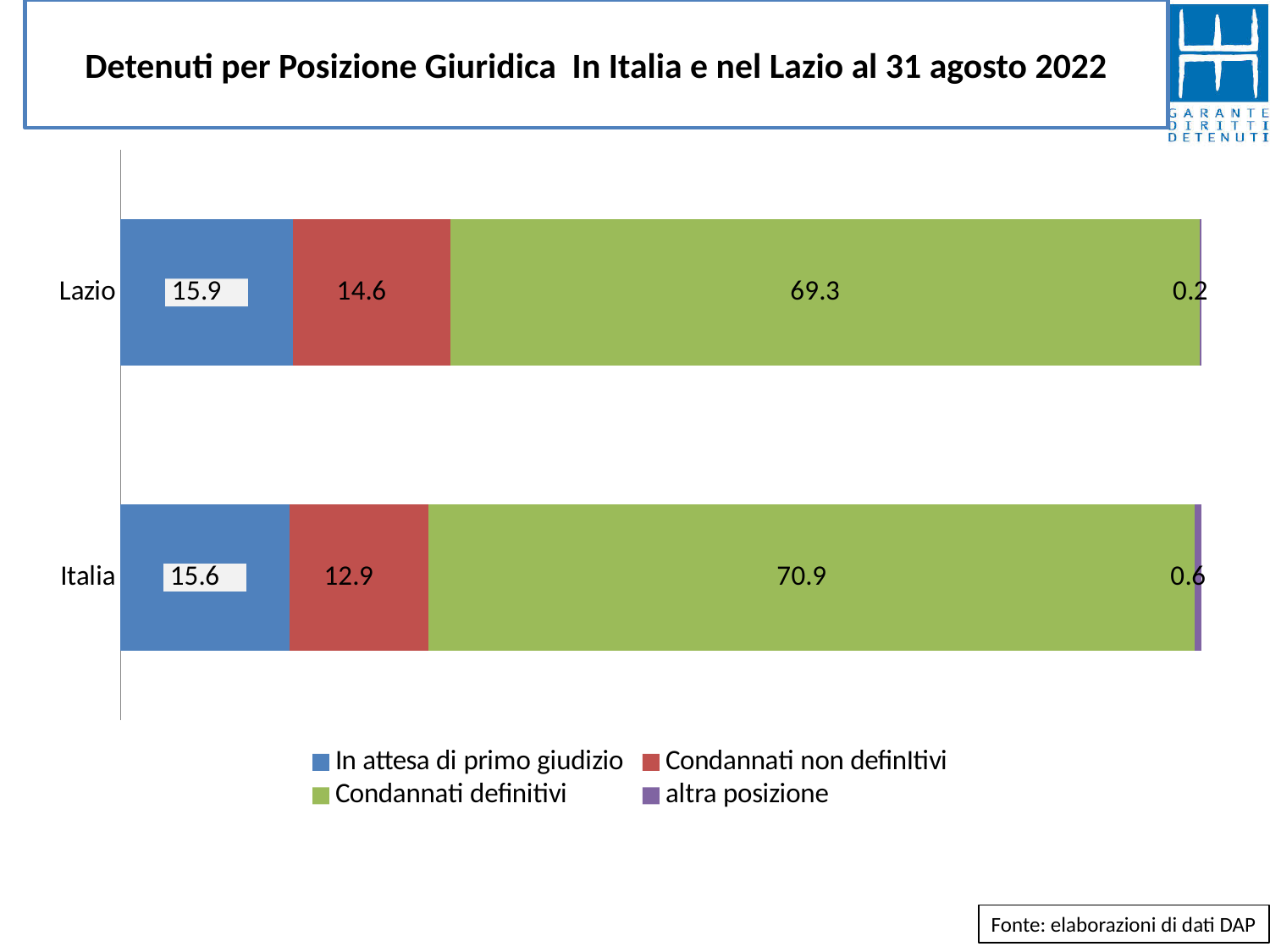
What is the total of the stacked bar for Lazio? 100.0 What is the value for 'Condannati non definitivi' for Italia? 12.9 What kind of chart is shown on the slide? Stacked bar chart Which series has the smallest value in the Lazio bar? altra posizione How many series does the legend list? 4 What is the value for 'Condannati definitivi' for Lazio? 69.3 What is the value for 'altra posizione' for Italia? 0.6 What is the difference between the 'Condannati definitivi' values for Italia and Lazio? 1.6 Which series has the largest value in the Italia bar? Condannati definitivi How many categories are shown on the vertical axis? 2 What is the value for 'In attesa di primo giudizio' for Lazio? 15.9 Which has the larger 'Condannati non definitivi' value, Lazio or Italia? Lazio